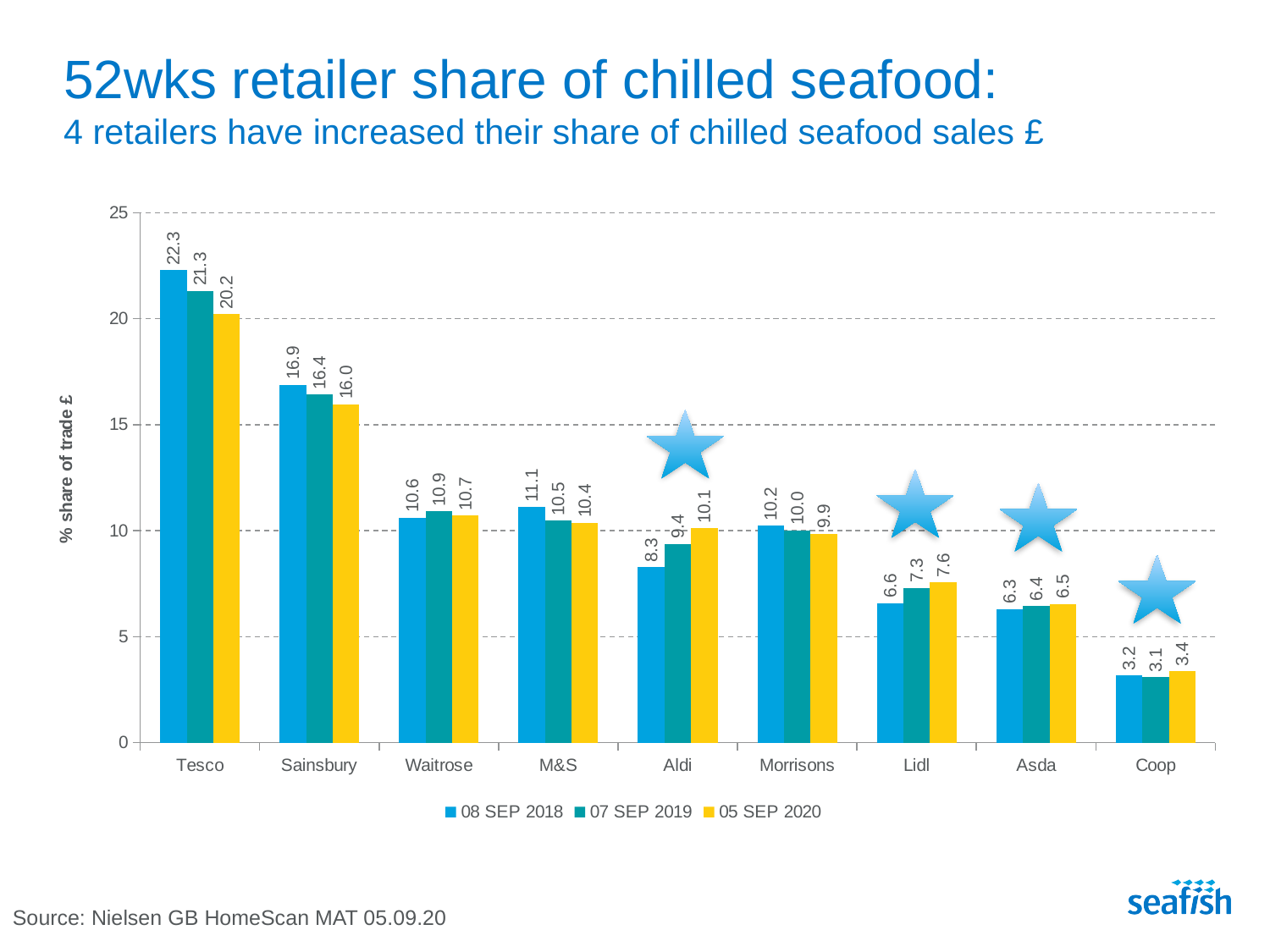
What kind of chart is shown on the slide? Bar chart How many retailers are shown on the x axis? 9 What is Lidl's share of trade for 07 SEP 2019? 7.3 What is Aldi's share of trade for 08 SEP 2018? 8.3 Do Aldi's values rise or fall from 08 SEP 2018 to 05 SEP 2020? Rise What is the label of the y axis? % share of trade £ Which is larger: Waitrose's share for 05 SEP 2020 or M&S's share for 05 SEP 2020? Waitrose Which retailer has the highest share of trade for 05 SEP 2020? Tesco What is the difference between Tesco's share for 08 SEP 2018 and 05 SEP 2020? 2.1 How many series does the legend list? 3 What is Tesco's share of trade for 05 SEP 2020? 20.2 Which retailer has the lowest share of trade for 08 SEP 2018? Coop